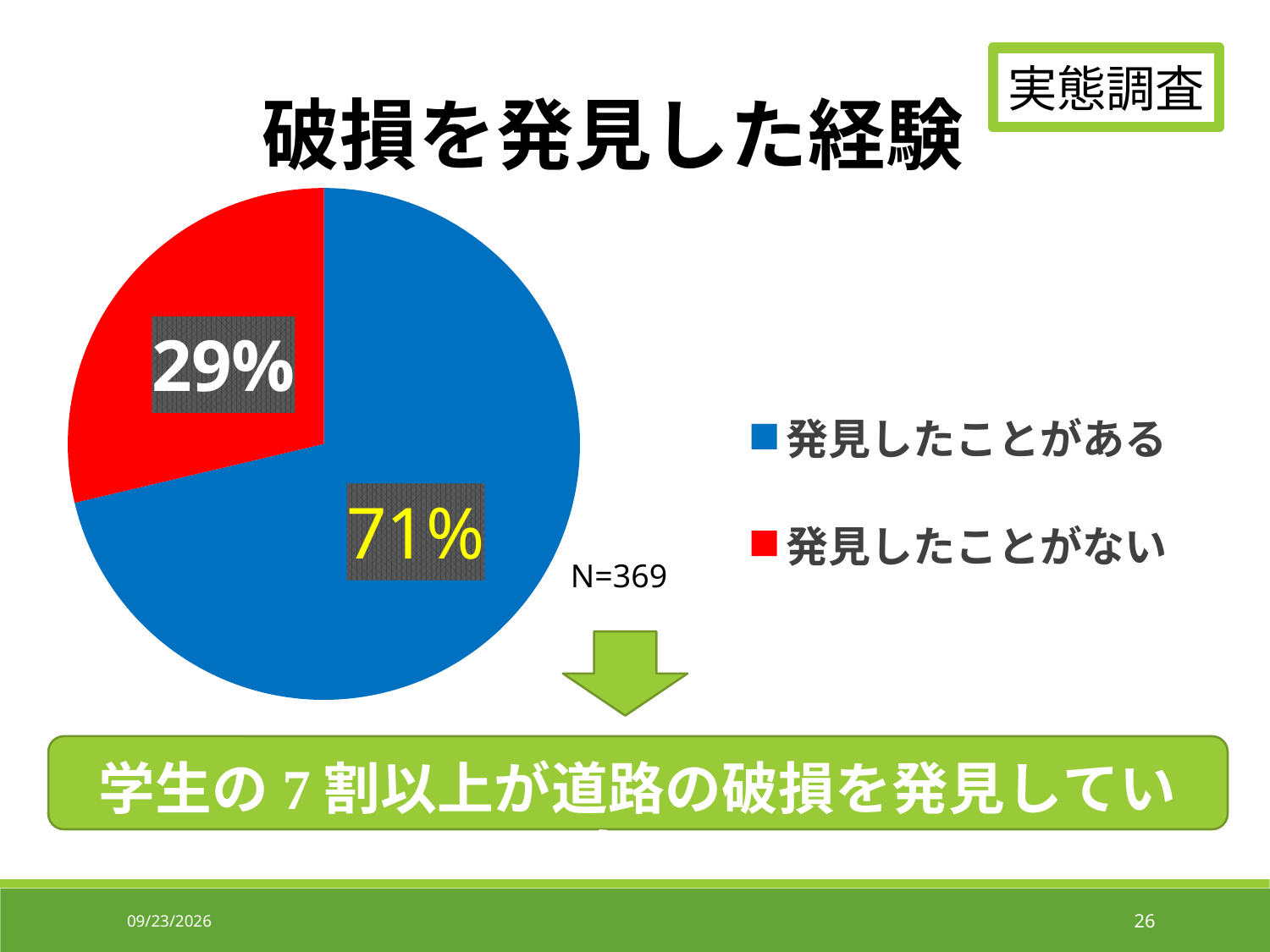
What kind of chart is shown on the slide? pie chart Which is larger, the 発見したことがある slice or the 発見したことがない slice? 発見したことがある How many entries does the legend list? 2 How many slices does the pie chart have? 2 What share of the pie is labelled 発見したことがない? 29% Which category has the largest slice of the pie? 発見したことがある What is the difference in percentage points between the 発見したことがある slice and the 発見したことがない slice? 42 What share of the pie is labelled 発見したことがある? 71% What is the sample size (N) shown next to the pie chart? N=369 What colour is the 発見したことがない slice? red Which category has the smallest slice of the pie? 発見したことがない What is the title of the chart? 破損を発見した経験